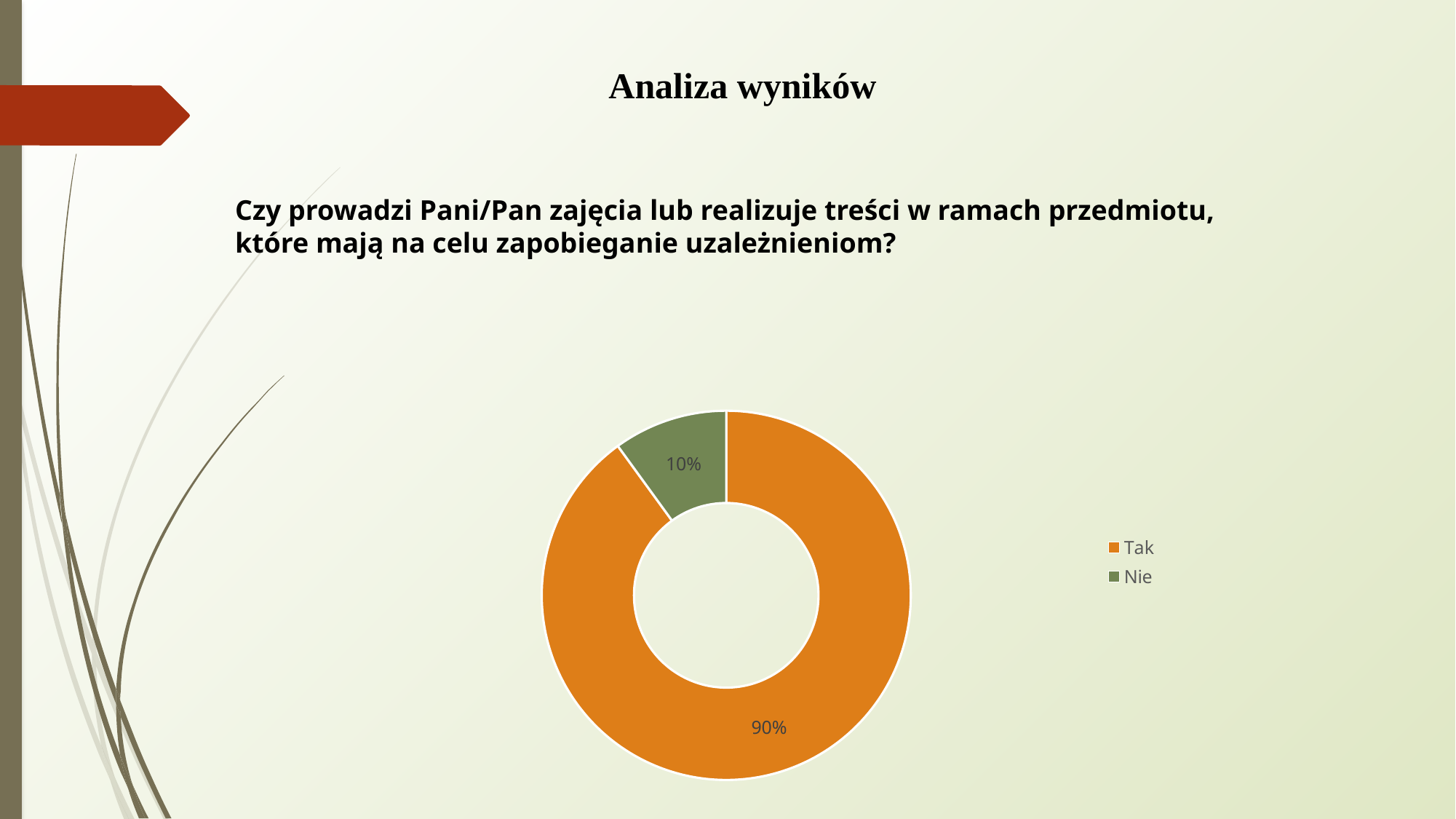
How many entries does the legend list? 2 What colour is the "Nie" slice? Green Which answer has the smallest share of the chart? Nie How many categories does the chart show? 2 Which answer has the largest share of the chart? Tak What colour is the "Tak" slice? Orange What kind of chart is shown on the slide? Doughnut (pie) chart What is the difference in percentage points between the "Tak" and "Nie" shares? 80 What percentage of respondents answered "Tak"? 90% Which is larger, the share for "Tak" or the share for "Nie"? Tak What share of the chart does the "Nie" slice represent? 10% What percentage of respondents answered "Nie"? 10%